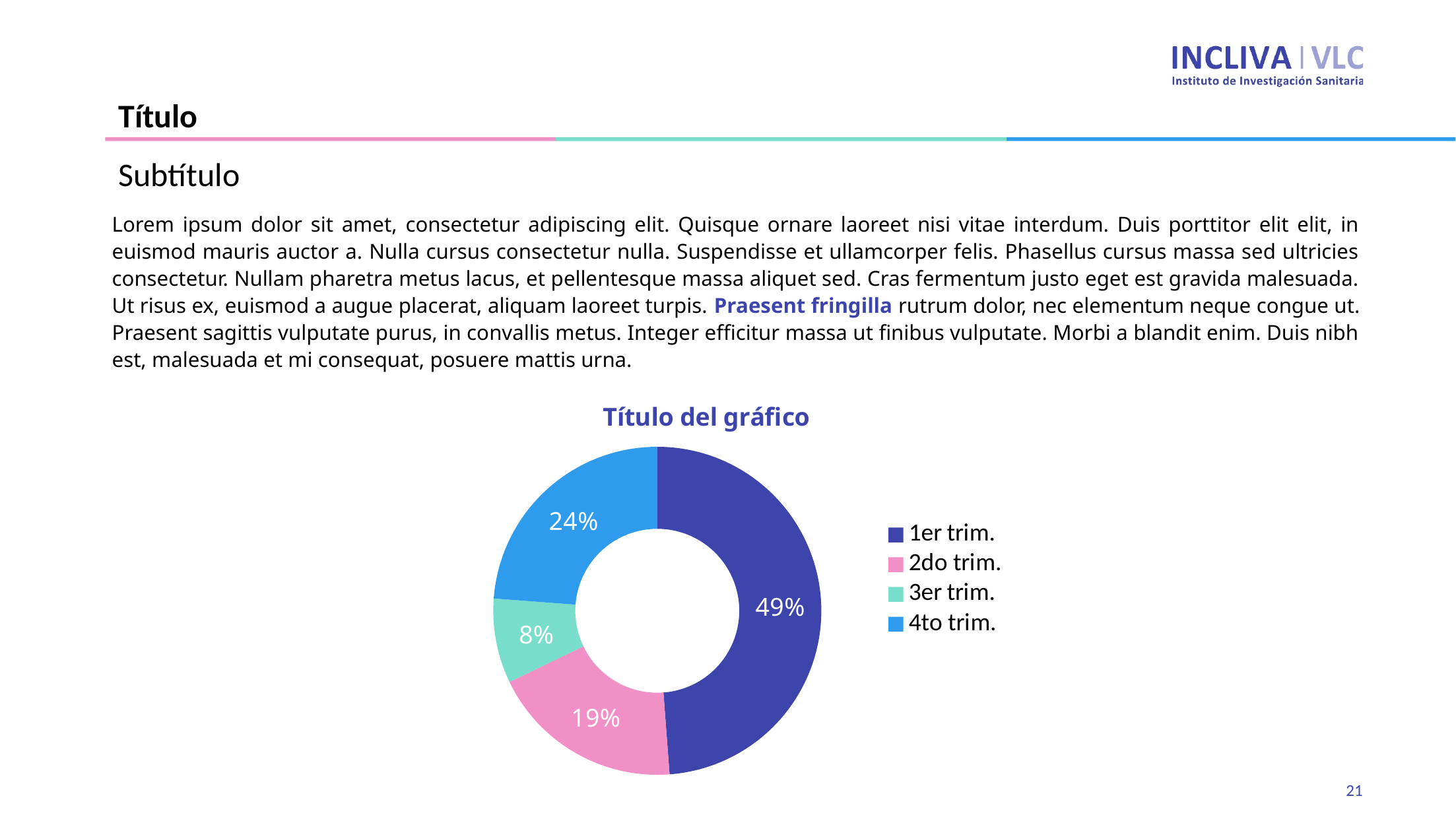
What is the title of the chart? Título del gráfico How many categories does the chart show? 4 What is the difference in percentage points between 1er trim. and 4to trim.? 25 Which category has the smallest slice? 3er trim. What share of the chart does 1er trim. represent? 49% What share of the chart does 4to trim. represent? 24% What is the difference in percentage points between 2do trim. and 3er trim.? 11 Which category has the largest slice? 1er trim. What share of the chart does 3er trim. represent? 8% Which is larger, 2do trim. or 4to trim.? 4to trim. What kind of chart is shown on the slide? Doughnut chart